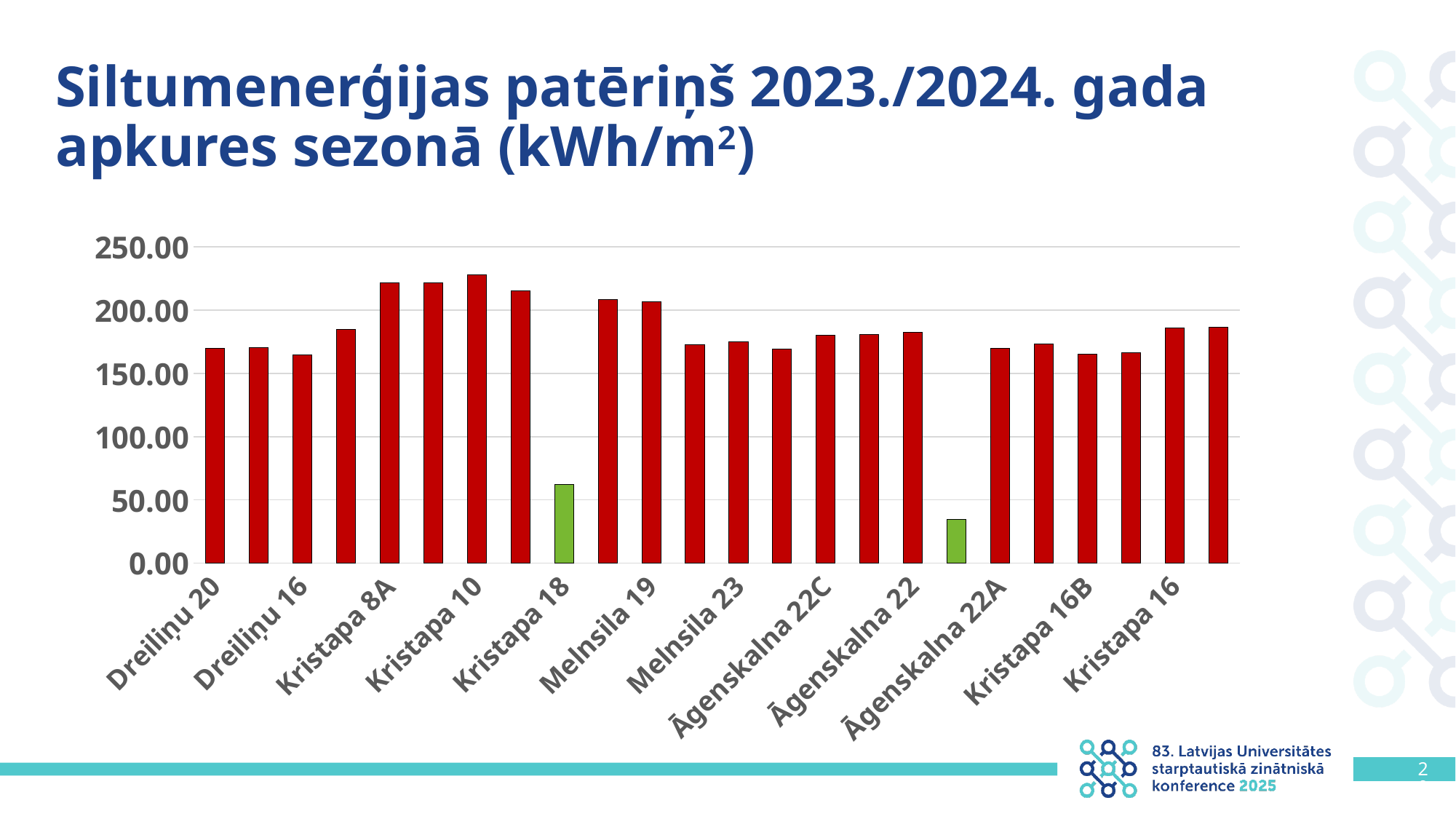
Which is larger, the value for Kristapa 18 or the value for Melnsila 19? Melnsila 19 Is the value for Kristapa 16 greater or less than 150? greater How many bars in the chart are coloured green rather than red? 2 What unit is given in the slide title for the heat energy consumption? kWh/m² Is the value for Dreiliņu 20 greater or less than 150? greater Is the value for Kristapa 8A greater or less than 200? greater What kind of chart is shown on the slide? bar chart Which is larger, the value for Kristapa 10 or the value for Kristapa 18? Kristapa 10 How many bars are plotted in the chart? 24